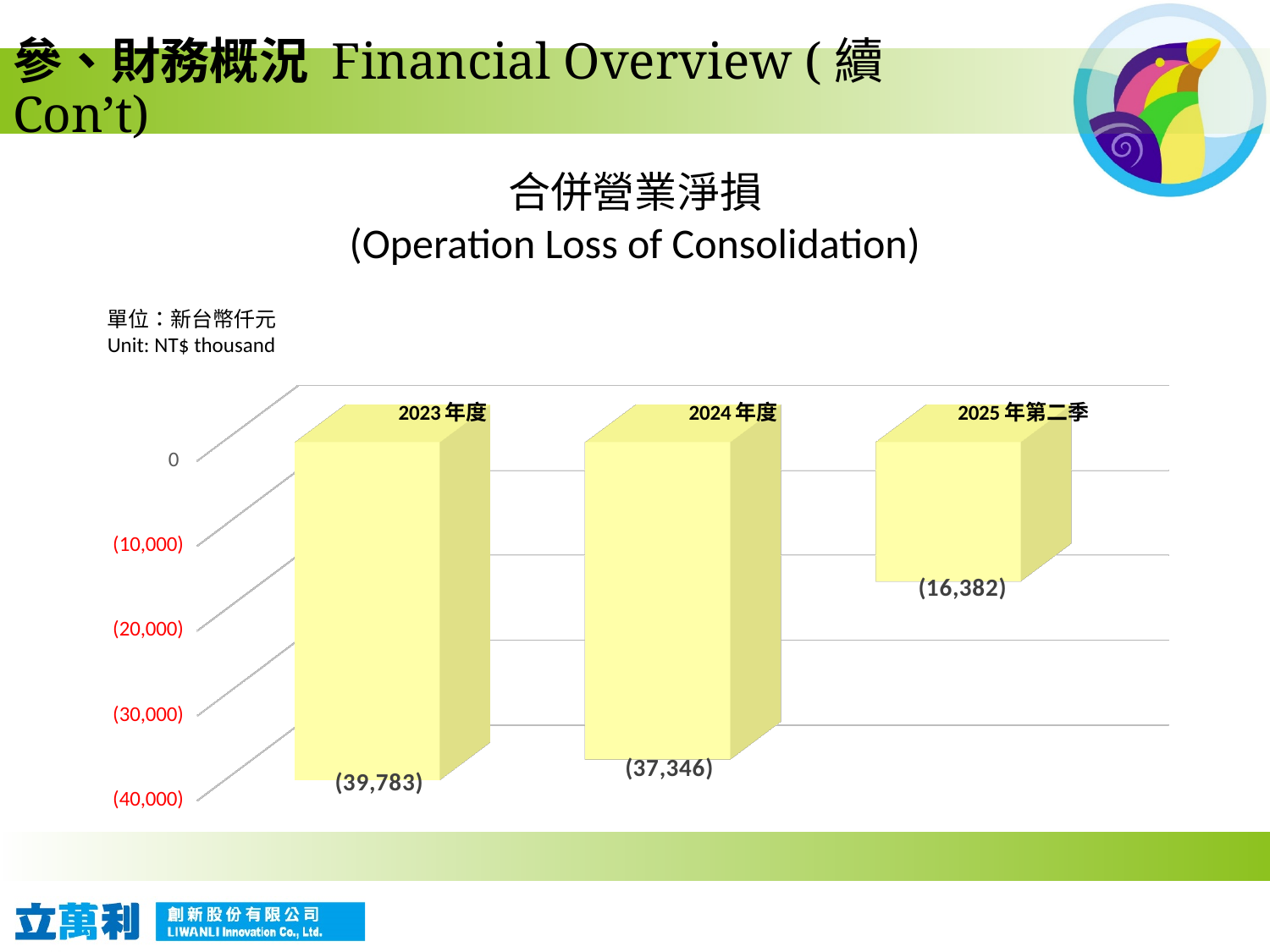
What is the value shown for 2023年度? (39,783) What unit is stated for the values in the chart? NT$ thousand Which has the larger operating loss, 2024年度 or 2025年第二季? 2024年度 Which category shows the smallest operating loss? 2025年第二季 How many categories are plotted in the chart? 3 By how much does the loss for 2023年度 exceed the loss for 2024年度? 2,437 Is the loss for 2025年第二季 greater or less than 20,000 in magnitude? less What is the value shown for 2025年第二季? (16,382) What is the value shown for 2024年度? (37,346) By how much does the loss for 2024年度 exceed the loss for 2025年第二季? 20,964 What kind of chart is shown on the slide? bar chart Which category shows the largest operating loss? 2023年度